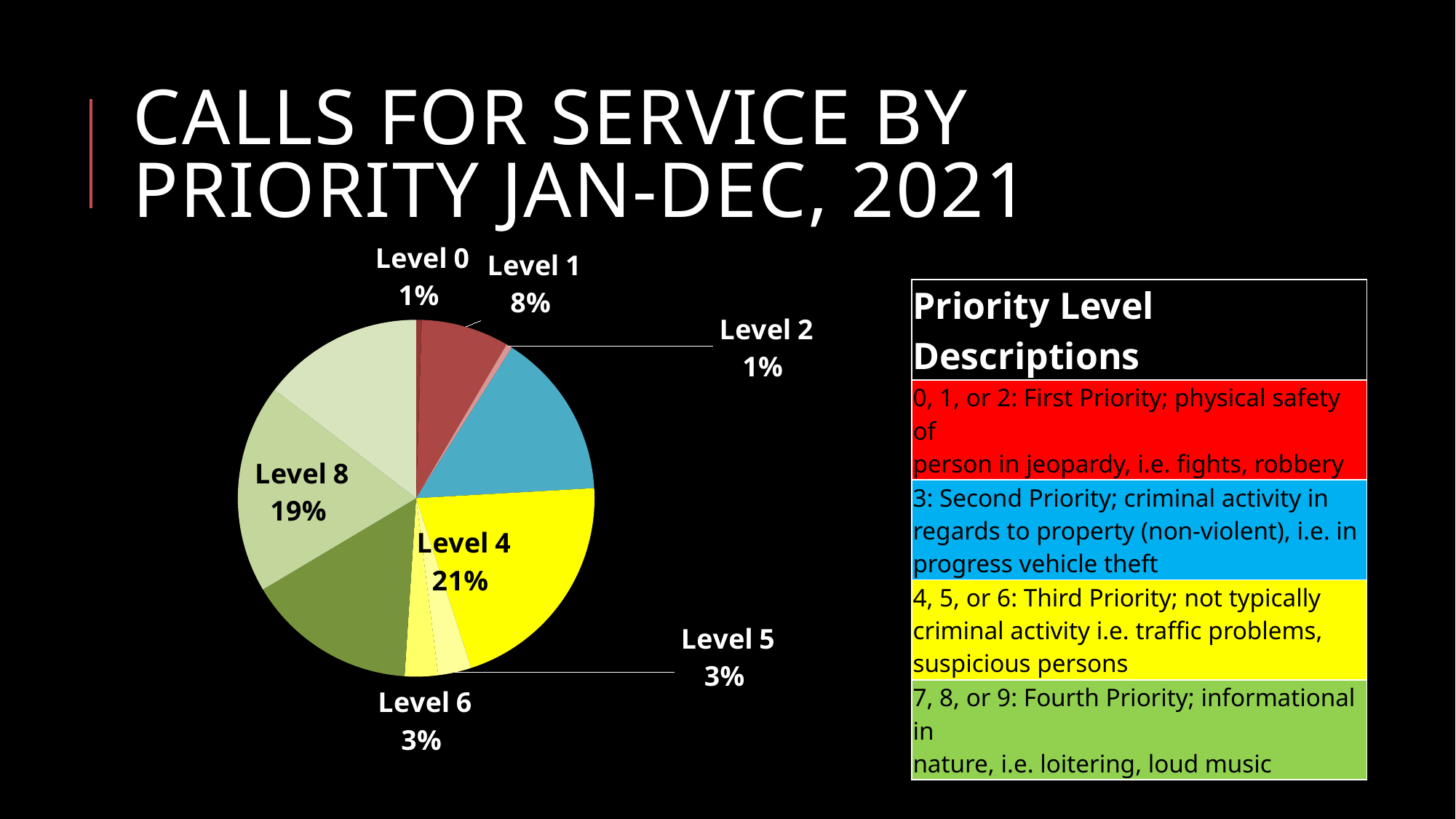
What is the difference in percentage points between Level 1 and Level 6? 5 What is the title of the slide containing the chart? Calls for Service by Priority Jan-Dec, 2021 Which is larger, the share for Level 1 or the share for Level 5? Level 1 What percentage is shown for Level 5? 3% Which labeled priority level has the largest share of calls for service? Level 4 What percentage of calls for service is Level 1? 8% What share of calls for service does Level 4 account for? 21% What kind of chart is shown on the slide? Pie chart What percentage is shown for Level 0? 1% What is the difference in percentage points between Level 4 and Level 8? 2 What percentage is shown for Level 2? 1% What percentage is shown for Level 8? 19%